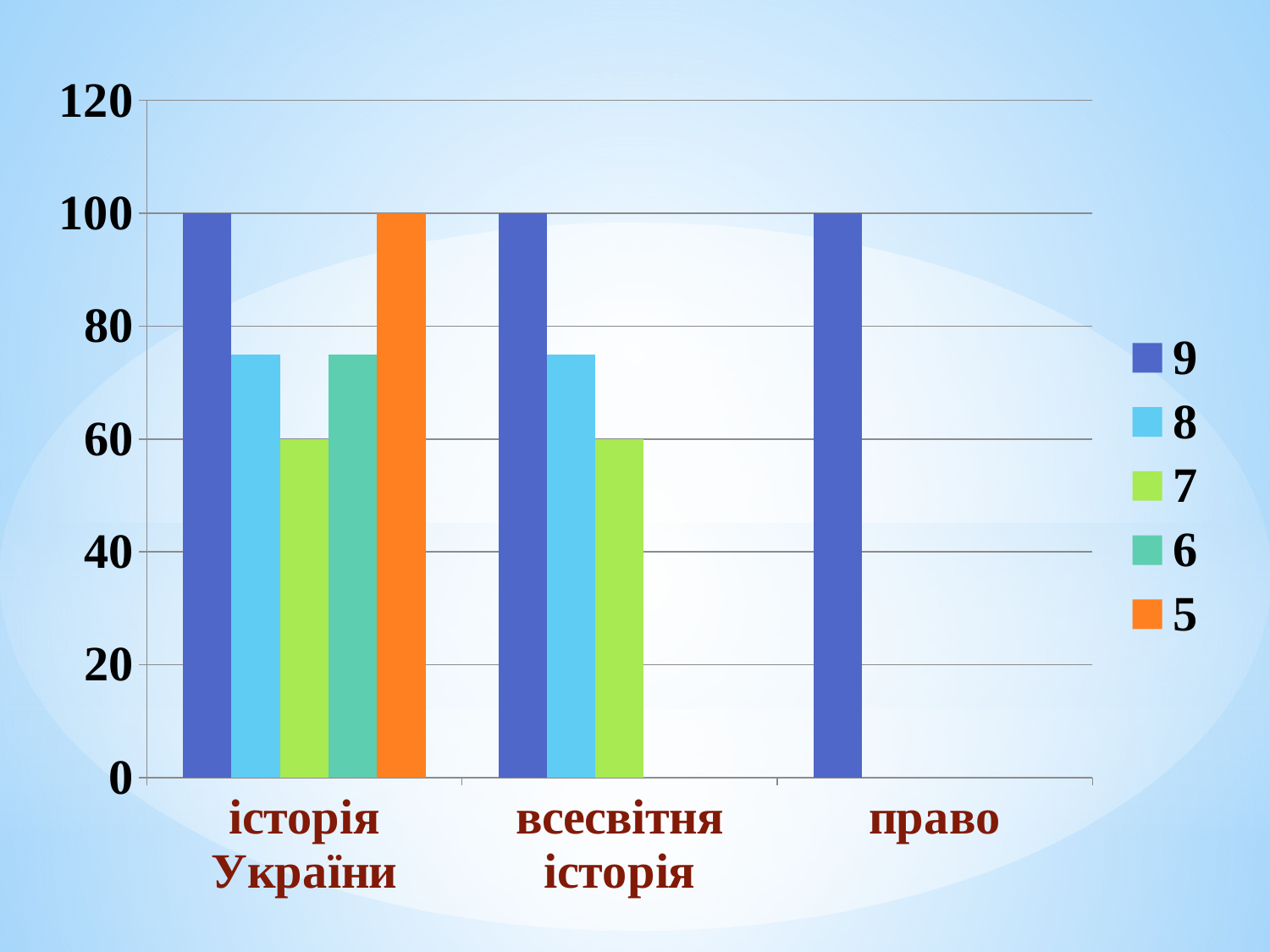
What is the value of series 9 for історія України? 100 How many categories are shown on the x axis? 3 What is the value of series 7 for всесвітня історія? 60 Is the value of series 6 for історія України greater or less than 60? greater Which series is the only one with a bar for право? 9 What is the difference between series 9 and series 7 for всесвітня історія? 40 Which is larger for історія України: series 8 or series 7? series 8 What kind of chart is shown on the slide? bar chart How many series does the legend list? 5 What is the value of series 5 for історія України? 100 Is the value of series 8 for історія України greater or less than 80? less